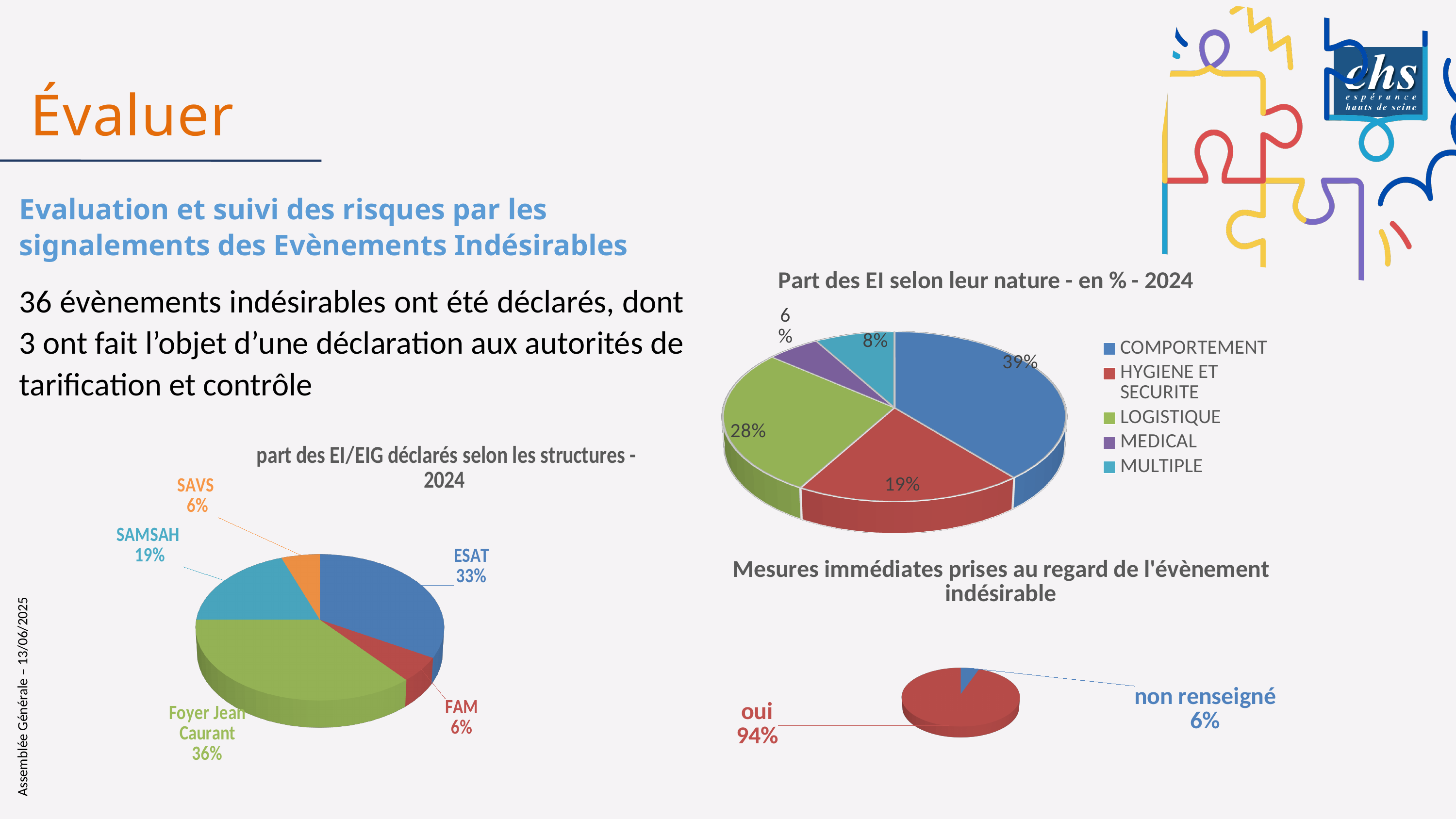
In the chart 'part des EI/EIG déclarés selon les structures - 2024', what share does ESAT have? 33% How many entries does the legend of the chart 'Part des EI selon leur nature - en % - 2024' list? 5 In the chart 'Part des EI selon leur nature - en % - 2024', which category has the smallest share? MEDICAL In the chart 'part des EI/EIG déclarés selon les structures - 2024', which structure has the largest share? Foyer Jean Caurant In the chart 'Part des EI selon leur nature - en % - 2024', which is larger: HYGIENE ET SECURITE or MULTIPLE? HYGIENE ET SECURITE In the chart 'part des EI/EIG déclarés selon les structures - 2024', how many structures are shown? 5 In the chart 'part des EI/EIG déclarés selon les structures - 2024', what is the difference between the shares of Foyer Jean Caurant and SAMSAH? 17 percentage points In the chart 'Part des EI selon leur nature - en % - 2024', what is the difference between COMPORTEMENT and HYGIENE ET SECURITE? 20 percentage points In the chart 'Mesures immédiates prises au regard de l'évènement indésirable', what share is 'oui'? 94% What kind of chart is 'Mesures immédiates prises au regard de l'évènement indésirable'? Pie chart In the chart 'Part des EI selon leur nature - en % - 2024', what share does LOGISTIQUE have? 28% In the chart 'Part des EI selon leur nature - en % - 2024', what colour represents COMPORTEMENT? Blue